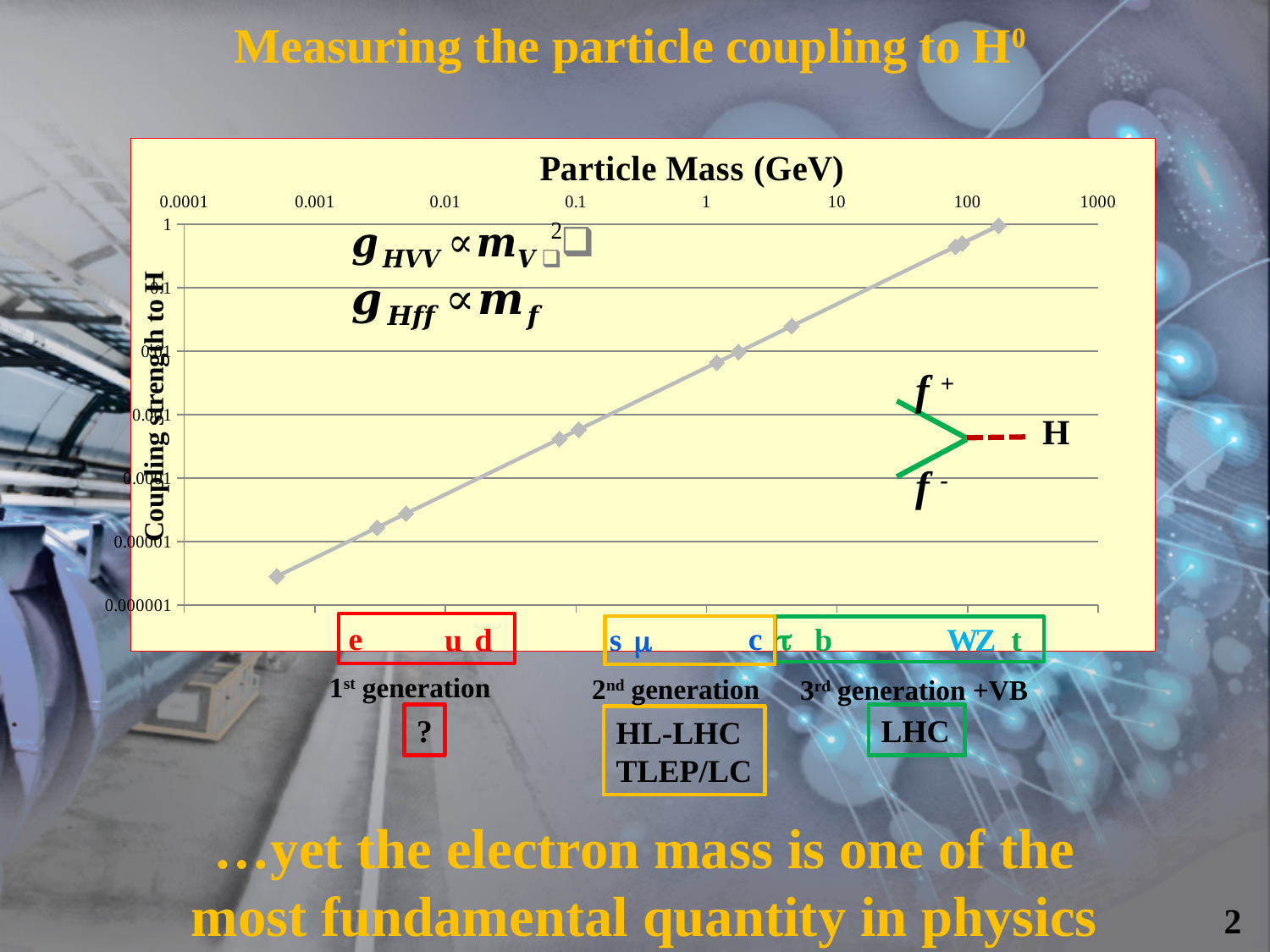
Is the coupling strength to H for the electron (e) greater or less than 0.00001? less Which has the larger coupling strength to H, the b quark or the c quark? b What is the title of the x axis of the chart? Particle Mass (GeV) Which particle has the lowest coupling strength to H in the chart? e How many tick labels are printed on the y axis of the chart? 7 Does the coupling strength to H rise or fall as particle mass increases along the x axis? rise Which particle has the highest coupling strength to H in the chart? t Is the coupling strength to H for the top quark (t) greater or less than 0.1? greater What kind of chart is shown on the slide? scatter chart with a line How many tick labels are printed on the x axis of the chart? 8 What is the largest value printed on the x axis of the chart? 1000 What is the title of the y axis of the chart? Coupling strength to H